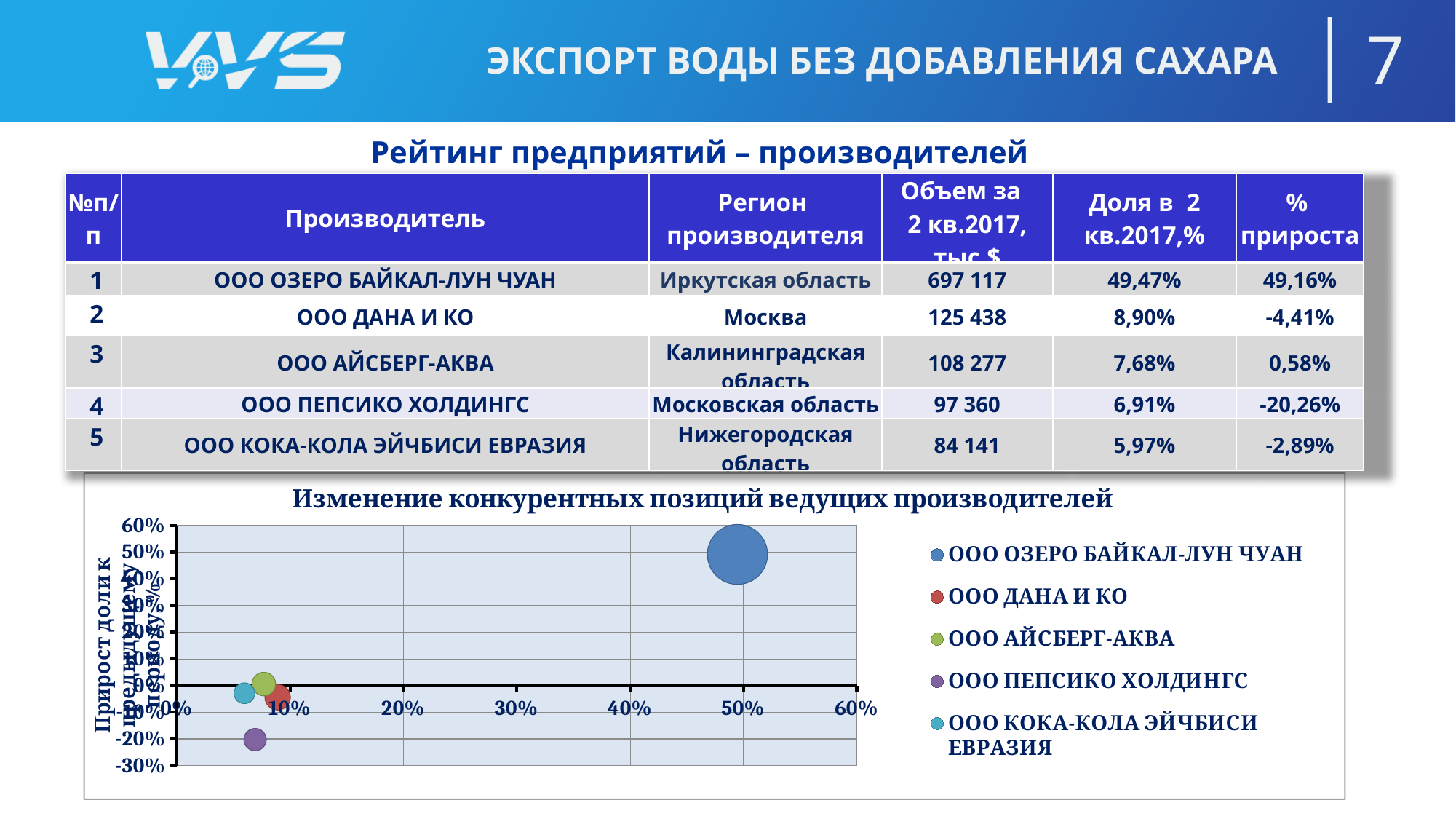
Which series in the chart is plotted with the largest bubble? ООО ОЗЕРО БАЙКАЛ-ЛУН ЧУАН Is the vertical-axis value for ООО ПЕПСИКО ХОЛДИНГС greater or less than -10%? less Which series has the highest value on the vertical axis of the chart? ООО ОЗЕРО БАЙКАЛ-ЛУН ЧУАН Which series has the lowest value on the vertical axis of the chart? ООО ПЕПСИКО ХОЛДИНГС Is the vertical-axis value for ООО ОЗЕРО БАЙКАЛ-ЛУН ЧУАН greater or less than 30%? greater How many series does the legend of the chart list? 5 What kind of chart is shown on the slide? bubble chart Which series has the larger horizontal-axis value in the chart, ООО ОЗЕРО БАЙКАЛ-ЛУН ЧУАН or ООО ДАНА И КО? ООО ОЗЕРО БАЙКАЛ-ЛУН ЧУАН Is the horizontal-axis value for ООО ДАНА И КО greater or less than 20%? less What is the title of the chart? Изменение конкурентных позиций ведущих производителей How many bubbles are plotted in the chart? 5